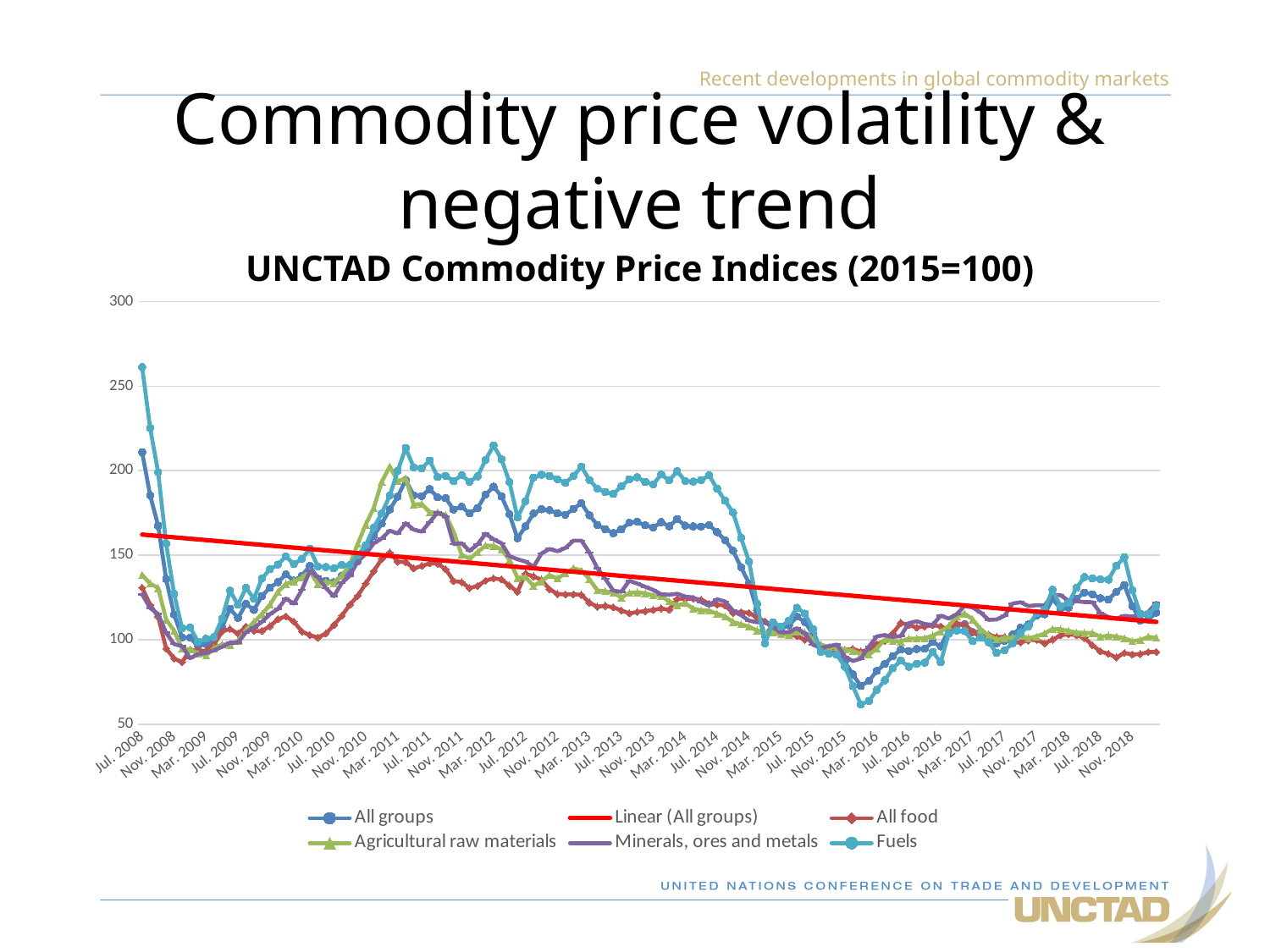
How many series does the legend list? 6 Is the lowest value reached by the Fuels series greater or less than 100? less Is the value for Fuels at Jul. 2008 greater or less than 250? greater Is the value for All groups at Jul. 2008 greater or less than 200? greater At Jul. 2008, which is larger: Fuels or All food? Fuels At Nov. 2018, which is larger: All groups or All food? All groups What colour is the Linear (All groups) line? red Does the Linear (All groups) trend line rise or fall from left to right? fall Which series reaches the highest value anywhere on the chart? Fuels What is the title of the chart? UNCTAD Commodity Price Indices (2015=100) What kind of chart is shown on the slide? line chart